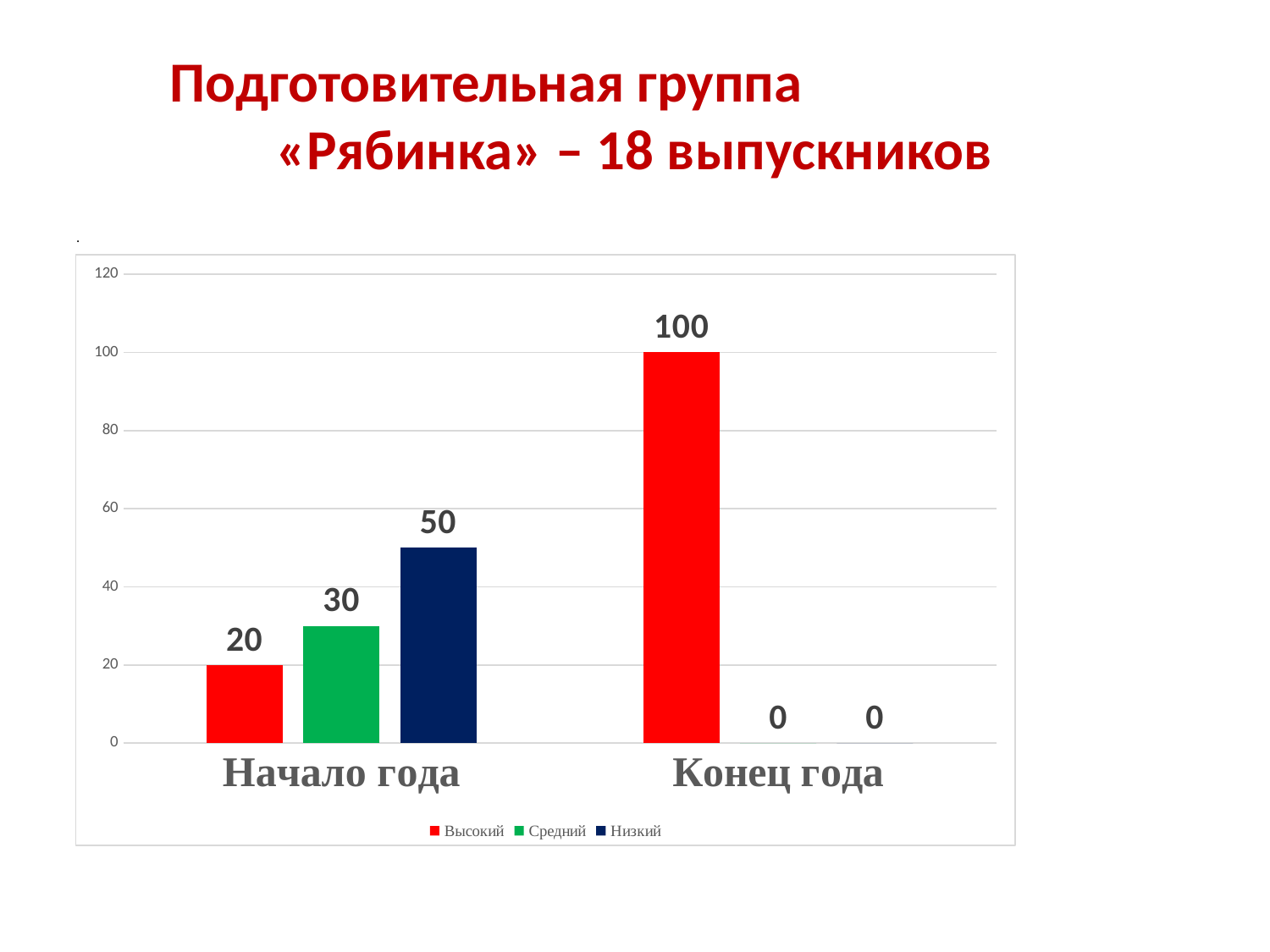
What is the value for Низкий at Начало года? 50 Which is larger at Начало года: Средний or Низкий? Низкий Which series has the highest value at Начало года? Низкий How many categories are shown on the x axis? 2 How many series does the legend list? 3 What is the value for Низкий at Конец года? 0 What is the value for Высокий at Начало года? 20 What kind of chart is shown on the slide? Bar chart What is the value for Средний at Начало года? 30 What is the difference between the Высокий value at Конец года and at Начало года? 80 What is the value for Высокий at Конец года? 100 Which series has the lowest value at Начало года? Высокий